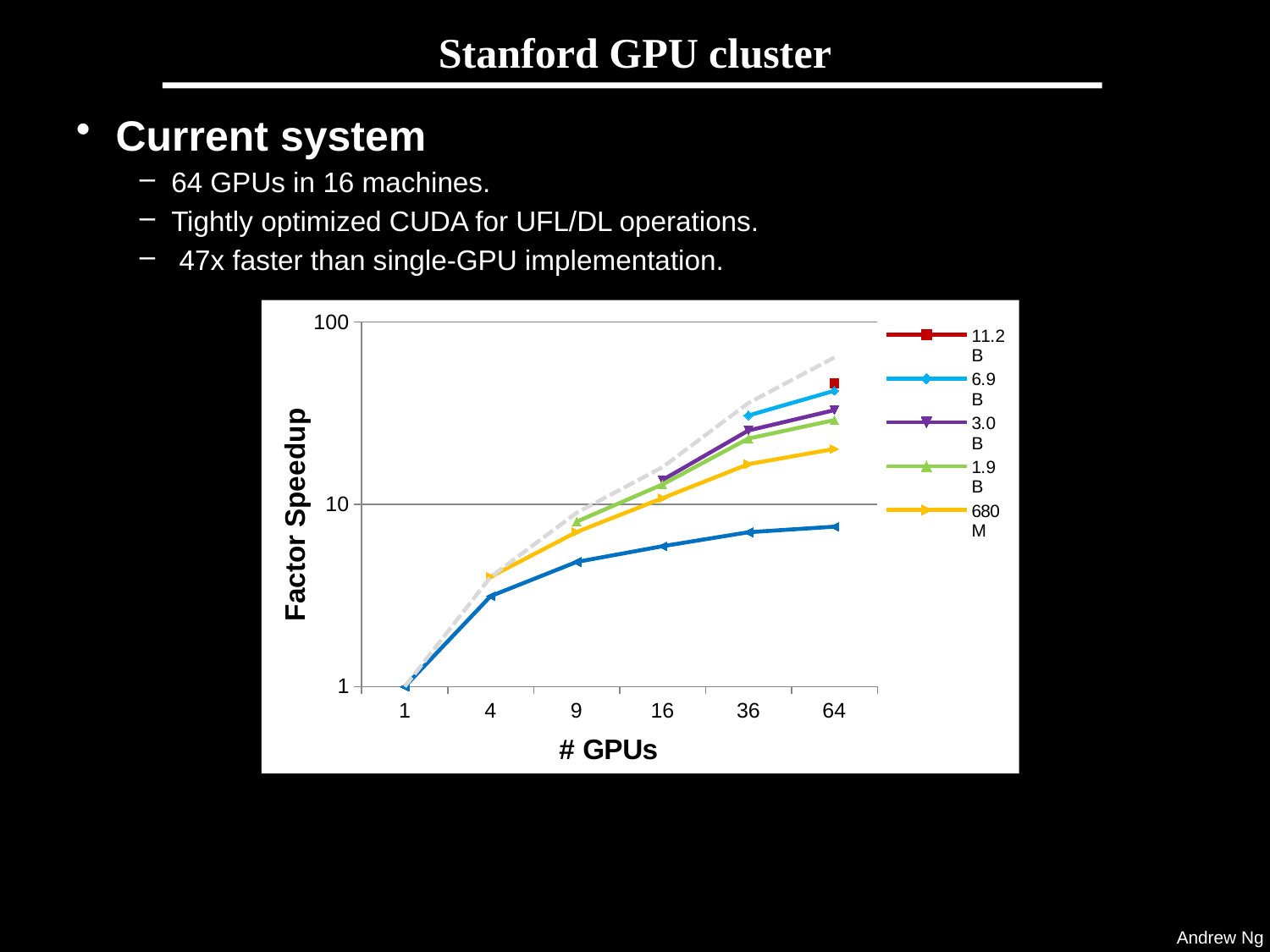
Is the factor speedup for the 1.9 B series at 9 GPUs greater or less than 10? less At 64 GPUs, which series has the higher factor speedup, 3.0 B or 1.9 B? 3.0 B Does the factor speedup for the 6.9 B series rise or fall as the number of GPUs increases? rise What is the label of the x axis of the chart? # GPUs Is the factor speedup for the 680 M series at 4 GPUs greater or less than 10? less At 64 GPUs, which series has the higher factor speedup, 6.9 B or 680 M? 6.9 B What kind of chart is shown on the slide? line chart Is the factor speedup for the 6.9 B series at 64 GPUs greater or less than 10? greater What is the label of the y axis of the chart? Factor Speedup How many # GPUs values are marked along the x axis of the chart? 6 How many series does the chart legend list? 5